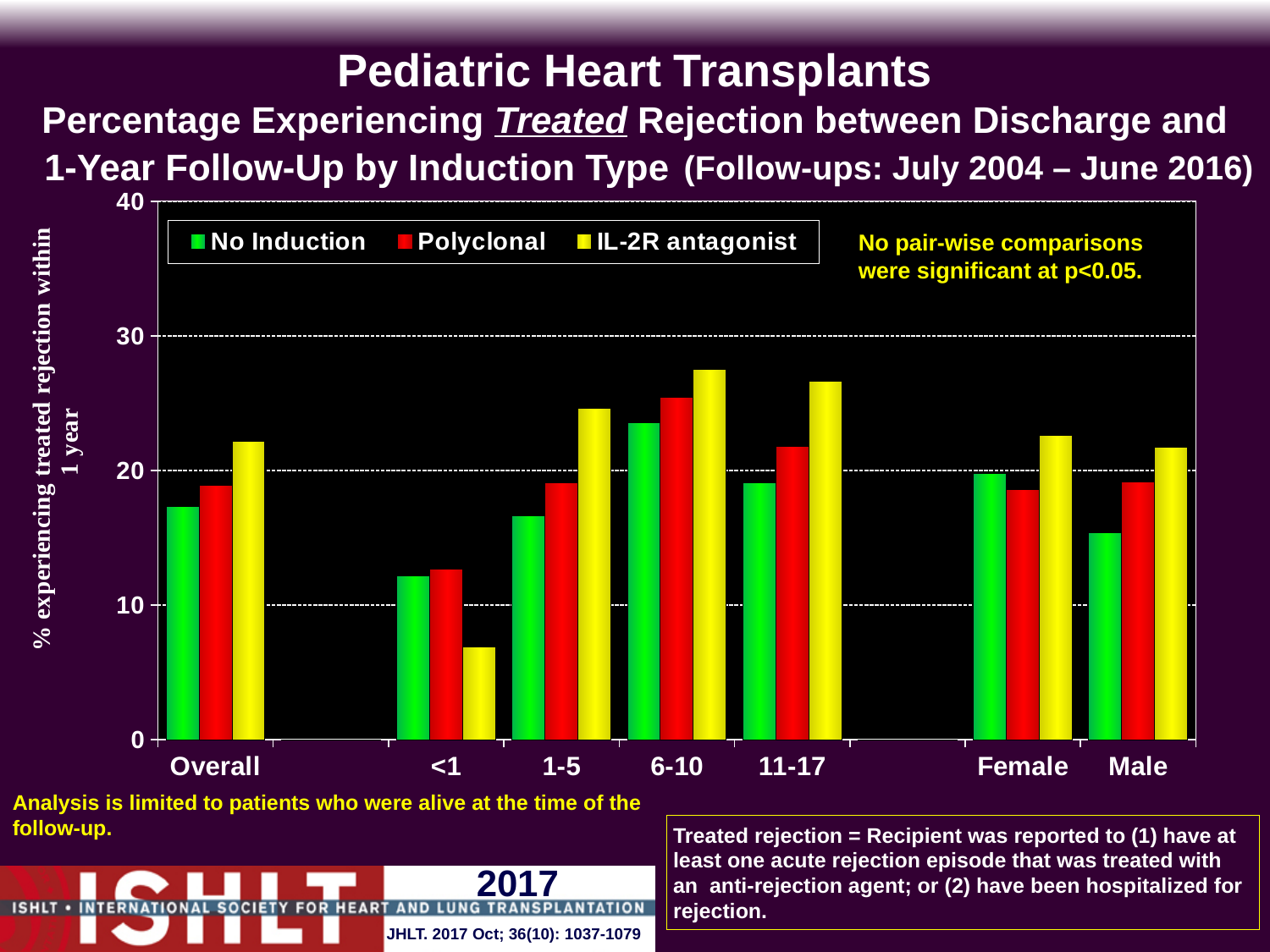
Is the IL-2R antagonist value for the 11-17 age group greater or less than 20? greater Is the No Induction value for Male greater or less than 20? less Is the IL-2R antagonist value for the <1 age group greater or less than 10? less Which category has the lowest IL-2R antagonist value? <1 How many series does the legend list? 3 Which category has the highest No Induction value? 6-10 How many categories are shown along the x axis? 7 In the <1 age group, which is larger: the No Induction value or the IL-2R antagonist value? No Induction Which colour represents the Polyclonal series in the legend? red For Male, which is larger: the Polyclonal value or the No Induction value? Polyclonal What kind of chart is shown on the slide? bar chart